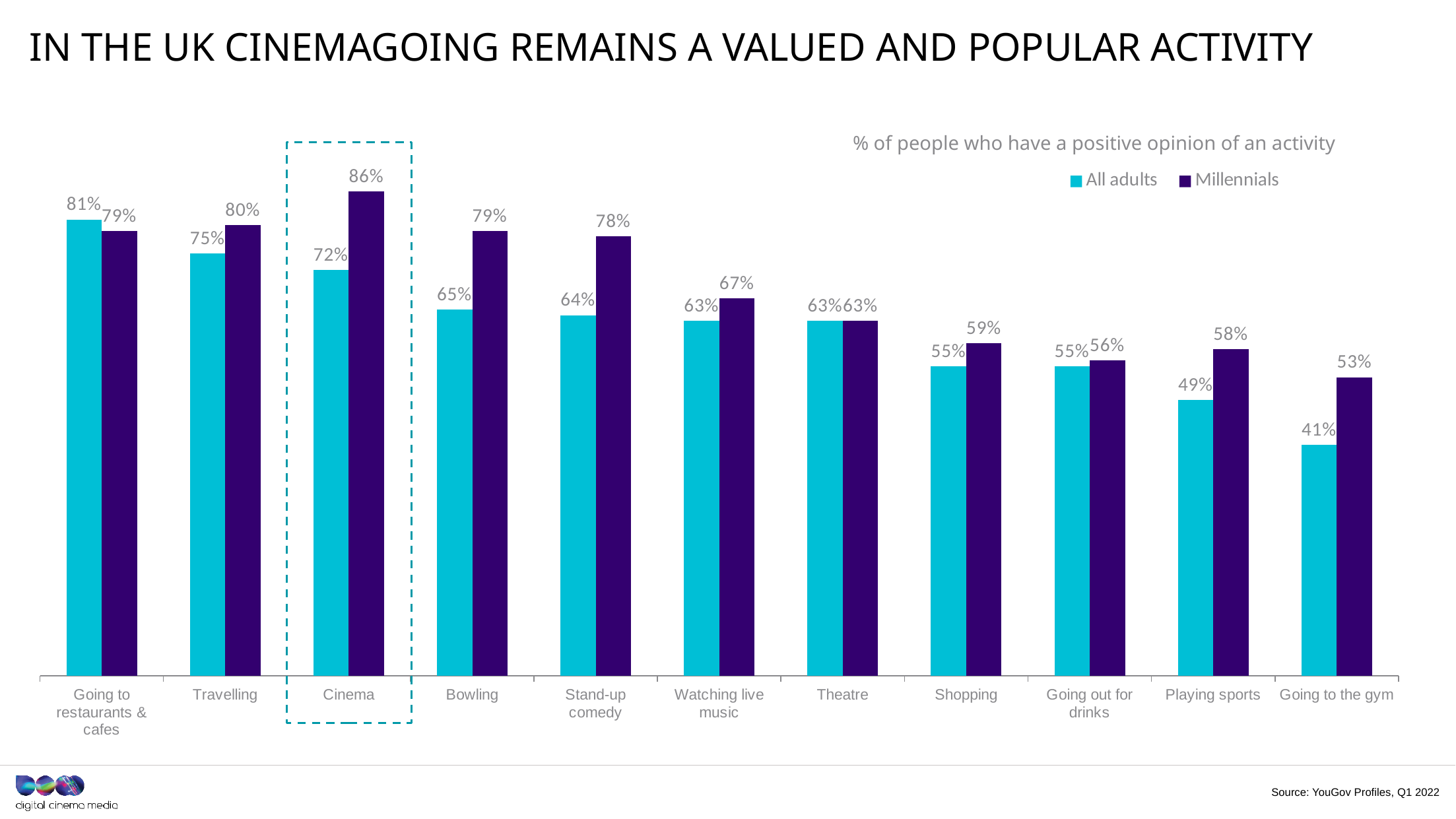
What is the difference between the All adults values for Going to restaurants & cafes and Going to the gym? 40% Which activity is highlighted with a dashed box? Cinema What kind of chart is shown on the slide? Bar chart Which activity has the lowest All adults value? Going to the gym Which activity has the highest Millennials value? Cinema What percentage of Millennials have a positive opinion of Cinema? 86% What is the Millennials value for Stand-up comedy? 78% What is the difference between the Millennials and All adults values for Cinema? 14% How many activities are shown on the x axis? 11 How many series does the legend list? 2 Which is larger for Going to restaurants & cafes: the All adults value or the Millennials value? All adults What percentage of All adults have a positive opinion of Cinema? 72%